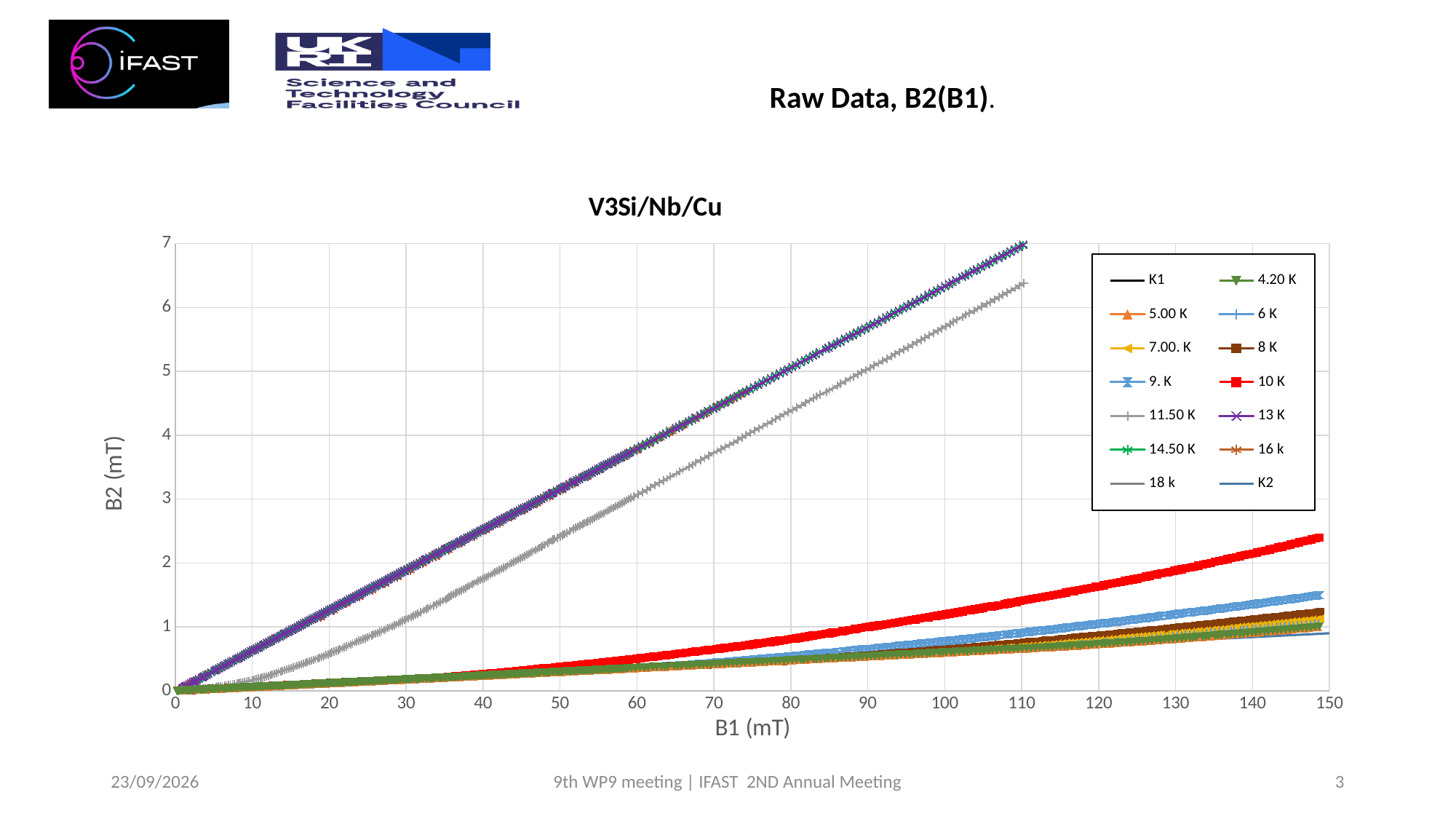
How many series does the legend of the chart list? 14 Among the series plotted out to B1 = 150 mT, which reaches the highest B2 value? 10 K At B1 = 150 mT, which series has the larger B2 value, 10 K or 9. K? 10 K Is the B2 value of the K2 series at B1 = 150 mT greater or less than 1? less Do the B2 values rise or fall as B1 increases along the x axis? rise What kind of chart is shown on the slide? line chart What is the title of the chart? V3Si/Nb/Cu Is the B2 value of the 11.50 K series at B1 = 110 mT greater or less than 6? greater Is the B2 value of the 9. K series at B1 = 150 mT greater or less than 1? greater At B1 = 100 mT, which series has the larger B2 value, 13 K or 11.50 K? 13 K What is the label of the vertical axis of the chart? B2 (mT)